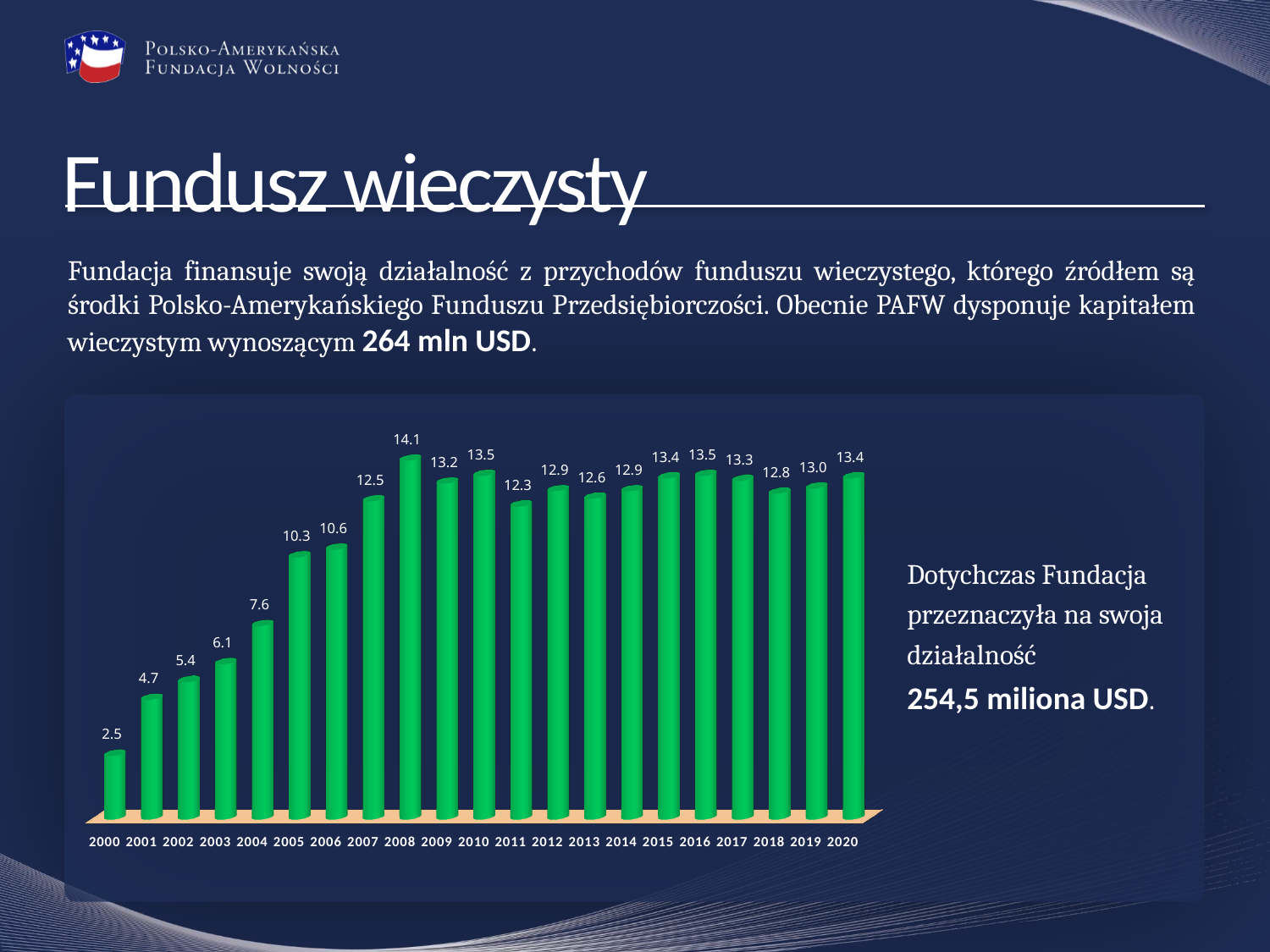
Which year has the lowest value? 2000 Which is larger, the value for 2007 or the value for 2011? 2007 How many years are shown on the x axis? 21 What kind of chart is shown on the slide? Bar chart Which year has the highest value? 2008 What is the difference between the values for 2008 and 2000? 11.6 What is the value shown for 2011? 12.3 What is the value shown for 2008? 14.1 What is the difference between the values for 2005 and 2004? 2.7 What is the value shown for 2000? 2.5 Do the values rise or fall from 2000 to 2008? Rise What is the value shown for 2020? 13.4